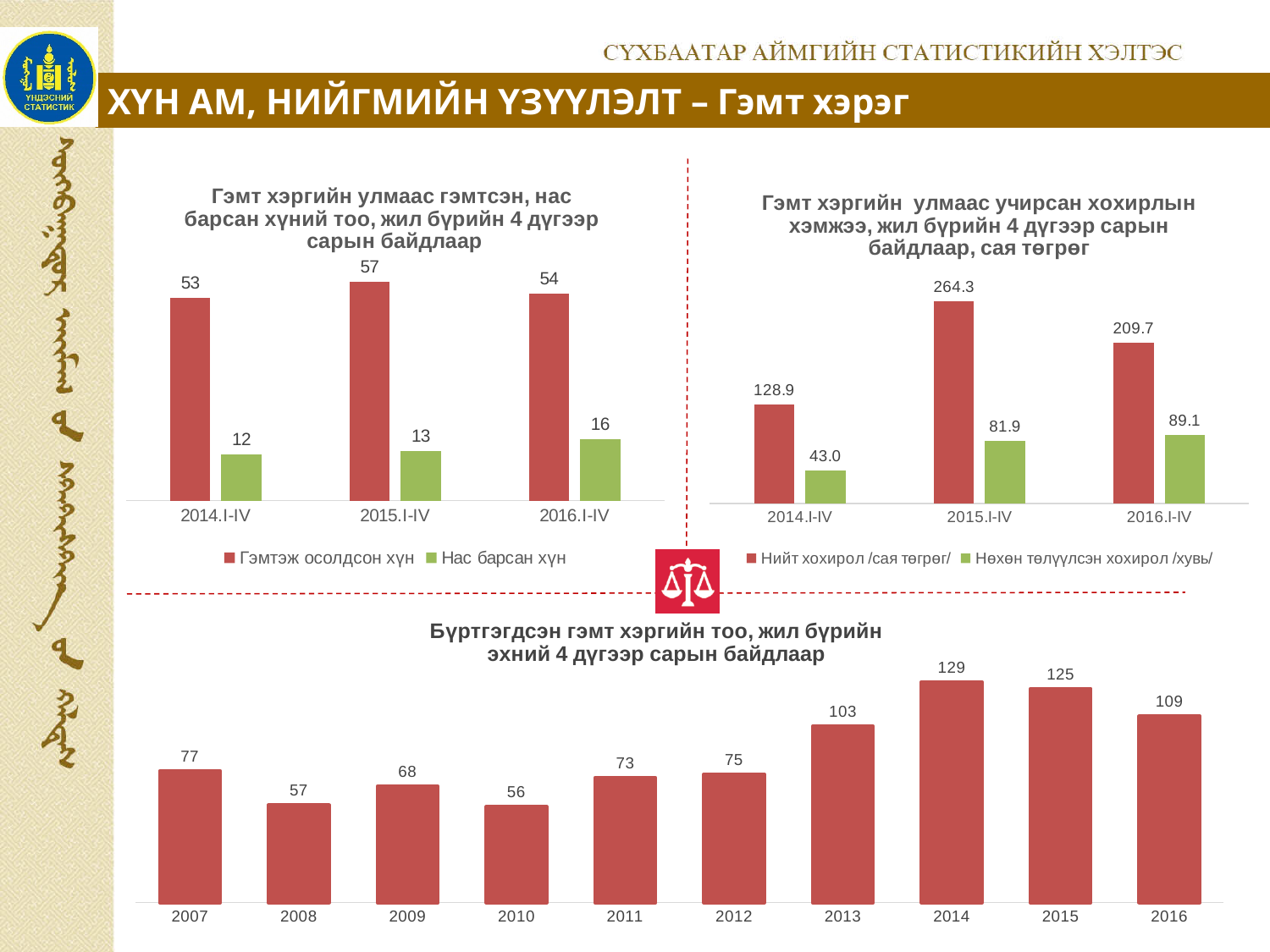
In the bottom chart (Бүртгэгдсэн гэмт хэргийн тоо), what is the value for 2014? 129 In the bottom chart (Бүртгэгдсэн гэмт хэргийн тоо), which year has the lowest value? 2010 In the bottom chart (Бүртгэгдсэн гэмт хэргийн тоо), how many years are shown on the x axis? 10 In the top-right chart (Гэмт хэргийн улмаас учирсан хохирлын хэмжээ), does the value for Нөхөн төлүүлсэн хохирол rise or fall from 2014.I-IV to 2016.I-IV? rise In the top-left chart (Гэмт хэргийн улмаас гэмтсэн, нас барсан хүний тоо), how many series does the legend list? 2 What kind of chart is the bottom chart (Бүртгэгдсэн гэмт хэргийн тоо)? bar chart In the top-left chart (Гэмт хэргийн улмаас гэмтсэн, нас барсан хүний тоо), in which period is the value for Гэмтэж осолдсон хүн highest? 2015.I-IV In the top-right chart (Гэмт хэргийн улмаас учирсан хохирлын хэмжээ), what is the value for Нийт хохирол in 2015.I-IV? 264.3 In the bottom chart (Бүртгэгдсэн гэмт хэргийн тоо), which year has the highest value? 2014 In the top-left chart (Гэмт хэргийн улмаас гэмтсэн, нас барсан хүний тоо), what is the value for Нас барсан хүн in 2016.I-IV? 16 In the top-right chart (Гэмт хэргийн улмаас учирсан хохирлын хэмжээ), what is the value for Нөхөн төлүүлсэн хохирол in 2014.I-IV? 43.0 In the bottom chart (Бүртгэгдсэн гэмт хэргийн тоо), what is the difference between the values for 2016 and 2007? 32